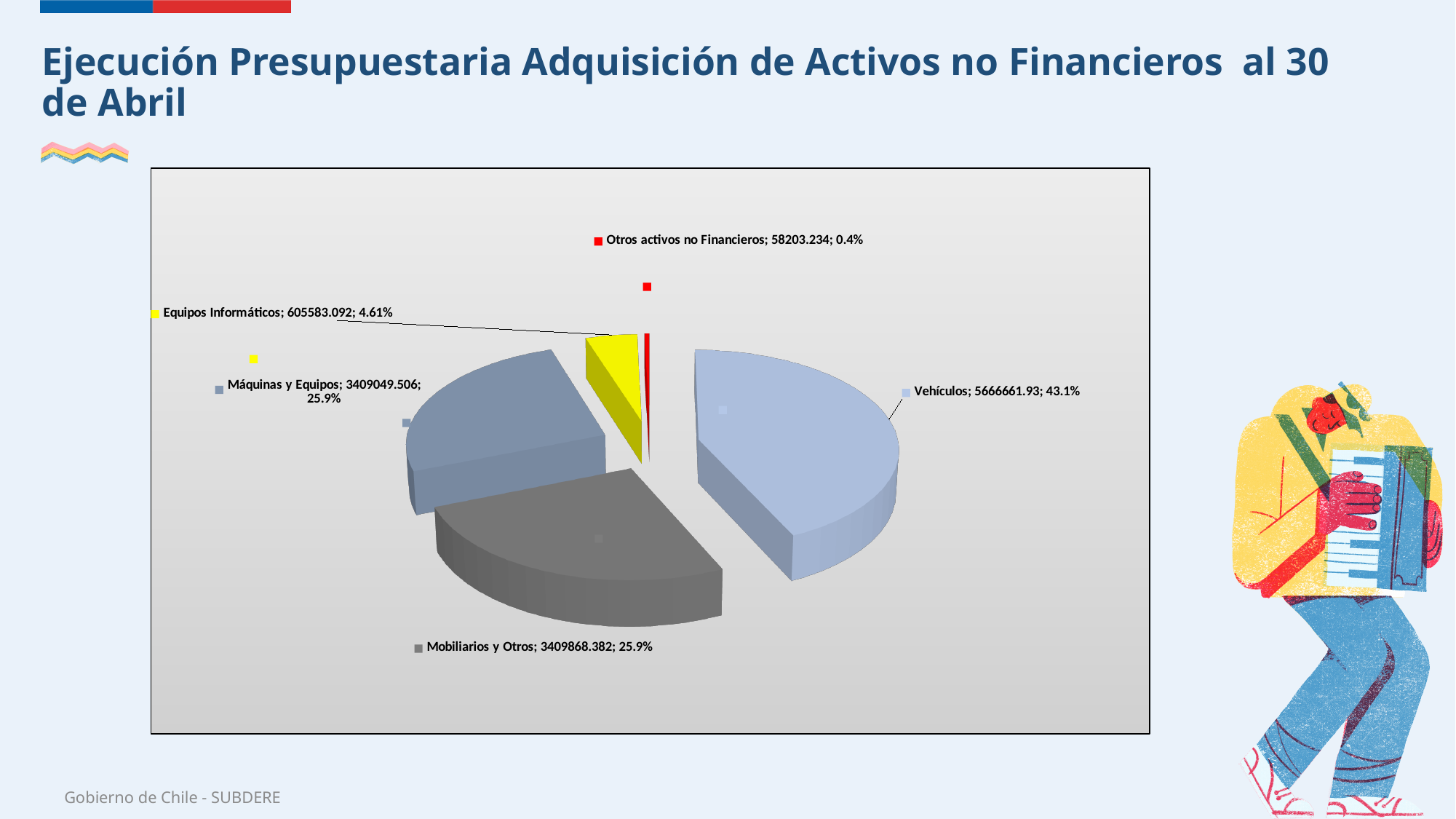
Which is larger, the value for Vehículos or the value for Máquinas y Equipos? Vehículos What is the value shown for Equipos Informáticos? 605583.092 What kind of chart is shown on the slide? Pie chart What share of the pie does Equipos Informáticos represent? 4.61% Which category has the largest slice of the pie? Vehículos Which category has the smallest slice of the pie? Otros activos no Financieros What share of the pie does Vehículos represent? 43.1% How many slices does the pie chart have? 5 What is the value shown for Otros activos no Financieros? 58203.234 What is the difference between the value for Vehículos and the value for Equipos Informáticos? 5061078.838 What is the value shown for Vehículos? 5666661.93 What colour is the Otros activos no Financieros slice? Red